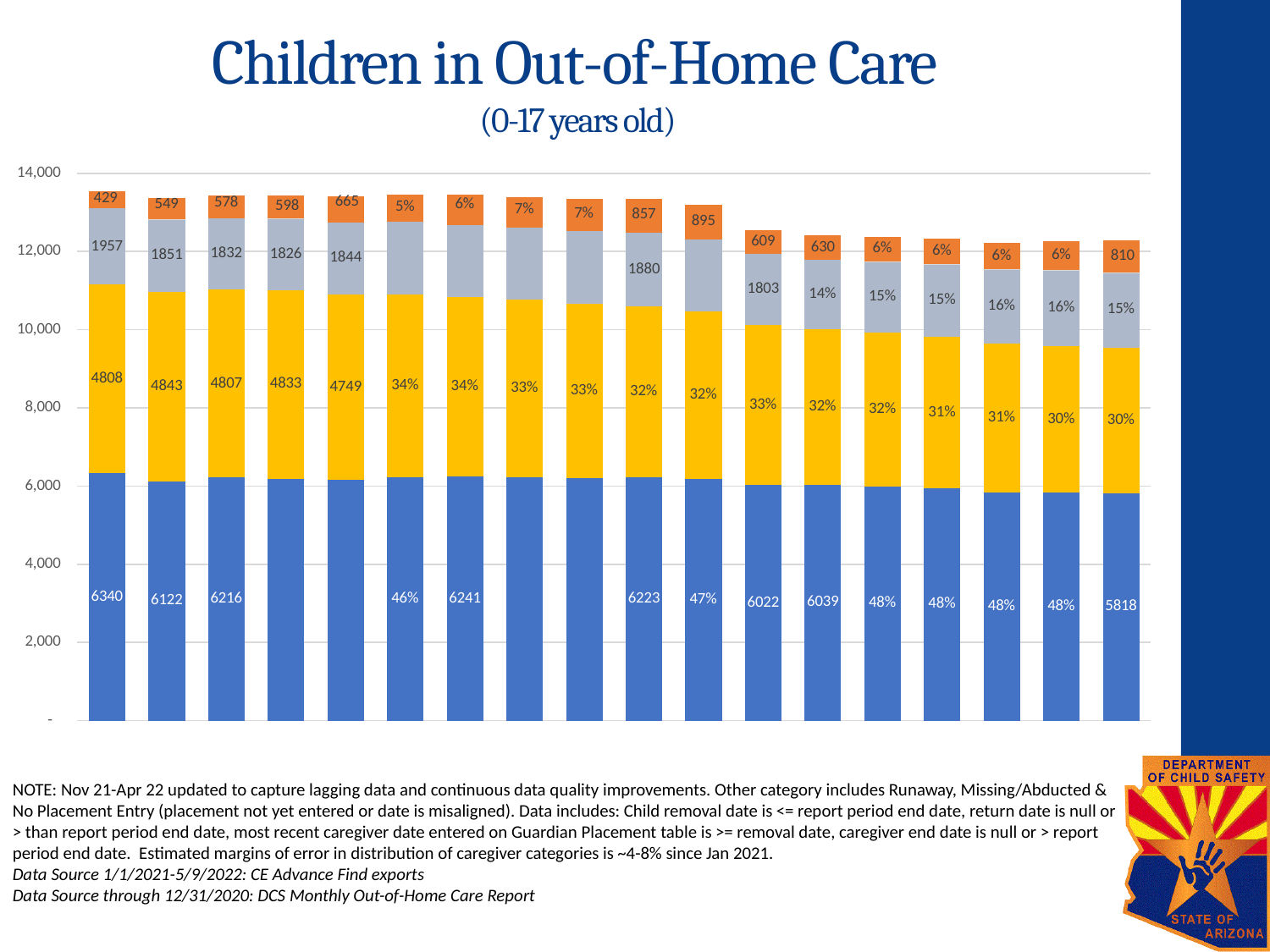
What is the value of the gray segment of the twelfth bar from the left? 1803 What is the value of the orange (top) segment of the first bar? 429 What is the difference between the blue segment of the first bar (6340) and the blue segment of the last bar (5818)? 522 Is the total height of the first bar greater or less than 13,000? greater Which is larger, the orange segment of the first bar or the orange segment of the last bar? The last bar (810) How many bars are plotted in the chart? 18 What is the value of the blue (bottom) segment of the last bar? 5818 What is the total of all four segments of the first bar? 13534 What is the title of the chart? Children in Out-of-Home Care (0-17 years old) Do the overall bar heights rise or fall from left to right across the chart? fall What type of chart is shown on the slide? Stacked bar chart What is the value of the blue (bottom) segment of the first bar? 6340